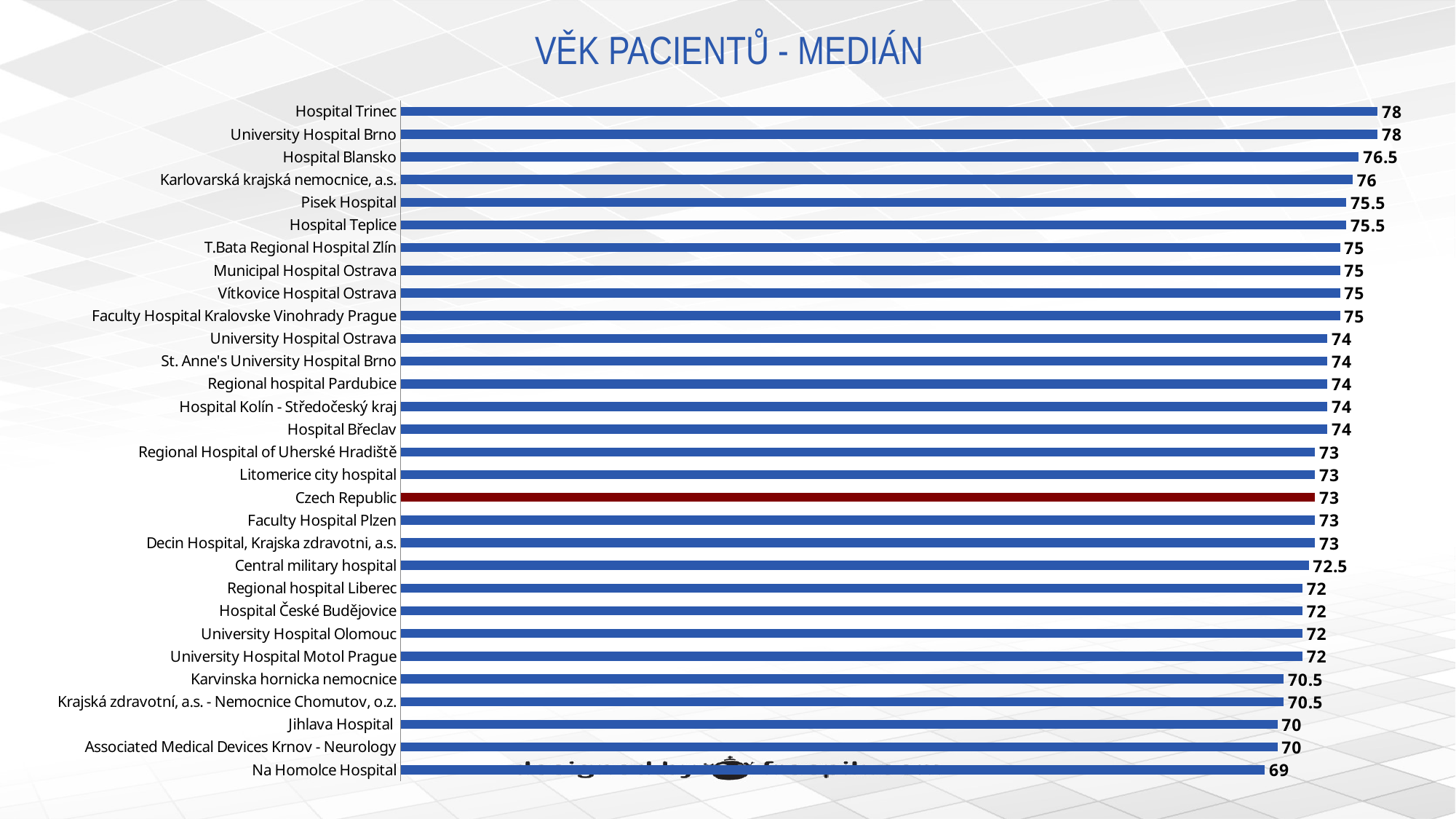
Which category's bar is coloured dark red instead of blue? Czech Republic What is the difference between the values for Karlovarská krajská nemocnice, a.s. and Czech Republic? 3 What is the median patient age for Central military hospital? 72.5 What is the value shown for Czech Republic? 73 What is the difference between the values for Hospital Trinec and Na Homolce Hospital? 9 Which has a higher median patient age, Pisek Hospital or Jihlava Hospital? Pisek Hospital Which hospital has the lowest median patient age? Na Homolce Hospital What is the value shown for Karvinska hornicka nemocnice? 70.5 What is the median patient age for Hospital Blansko? 76.5 Which has a lower value, University Hospital Motol Prague or Hospital Teplice? University Hospital Motol Prague What kind of chart is shown on the slide? Bar chart How many categories are plotted on the chart? 30